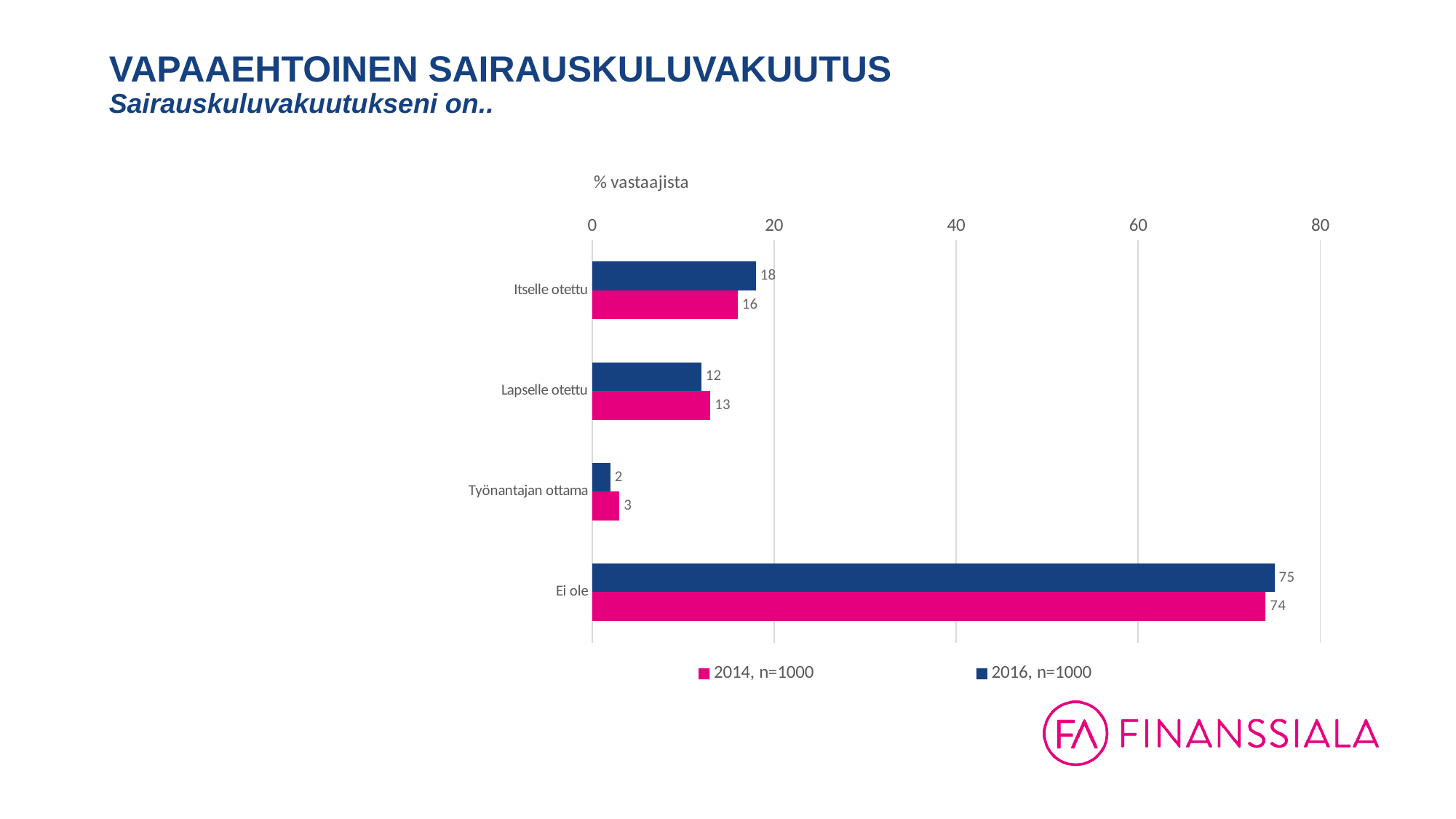
How many categories are shown on the chart? 4 What is the value for "Itselle otettu" in the 2016, n=1000 series? 18 What is the value for "Lapselle otettu" in the 2014, n=1000 series? 13 For "Lapselle otettu", which series has the larger value, 2014 or 2016? 2014, n=1000 Which category has the lowest value in the 2014, n=1000 series? Työnantajan ottama How many series does the legend list? 2 What is the difference between the 2016 and 2014 values for "Itselle otettu"? 2 What kind of chart is shown on the slide? Bar chart What is the axis label shown above the chart? % vastaajista What is the value for "Työnantajan ottama" in the 2016, n=1000 series? 2 What is the value for "Ei ole" in the 2014, n=1000 series? 74 Which category has the highest value in the 2016, n=1000 series? Ei ole